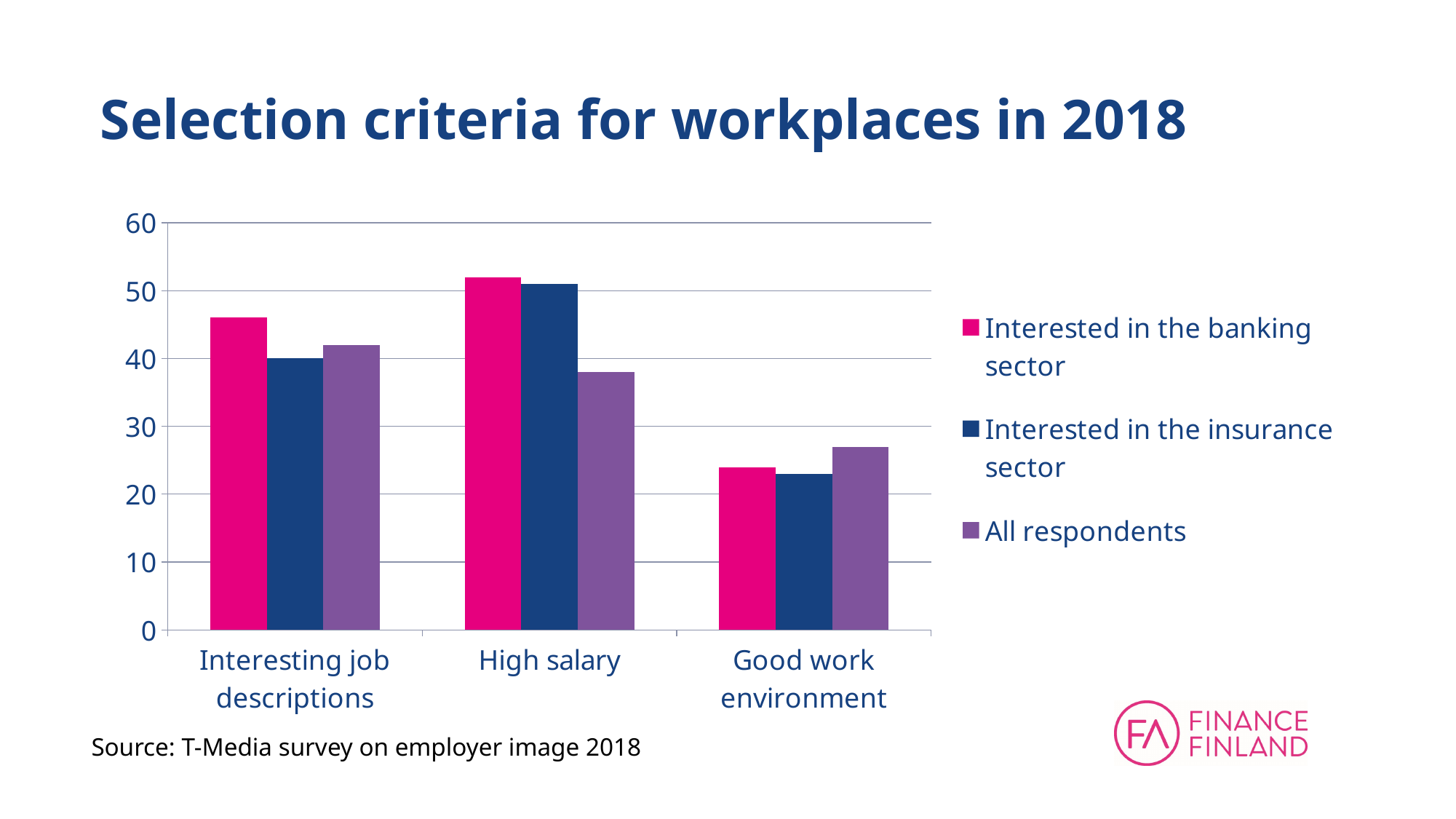
For All respondents, which criterion has the lowest value? Good work environment What kind of chart is shown on the slide? Bar chart How many series does the legend list? 3 Is the value for Good work environment among those interested in the insurance sector greater or less than 30? less For High salary, which is larger: the value for those interested in the banking sector or the value for All respondents? Interested in the banking sector For respondents interested in the banking sector, which criterion has the highest value? High salary Is the value for Interesting job descriptions among those interested in the banking sector greater or less than 40? greater Do the values for All respondents rise or fall from left to right across the three criteria? fall How many selection criteria categories are shown on the x axis? 3 Is the value for High salary among All respondents greater or less than 40? less For Good work environment, which is larger: the value for All respondents or the value for those interested in the insurance sector? All respondents What is the title of the chart on the slide? Selection criteria for workplaces in 2018